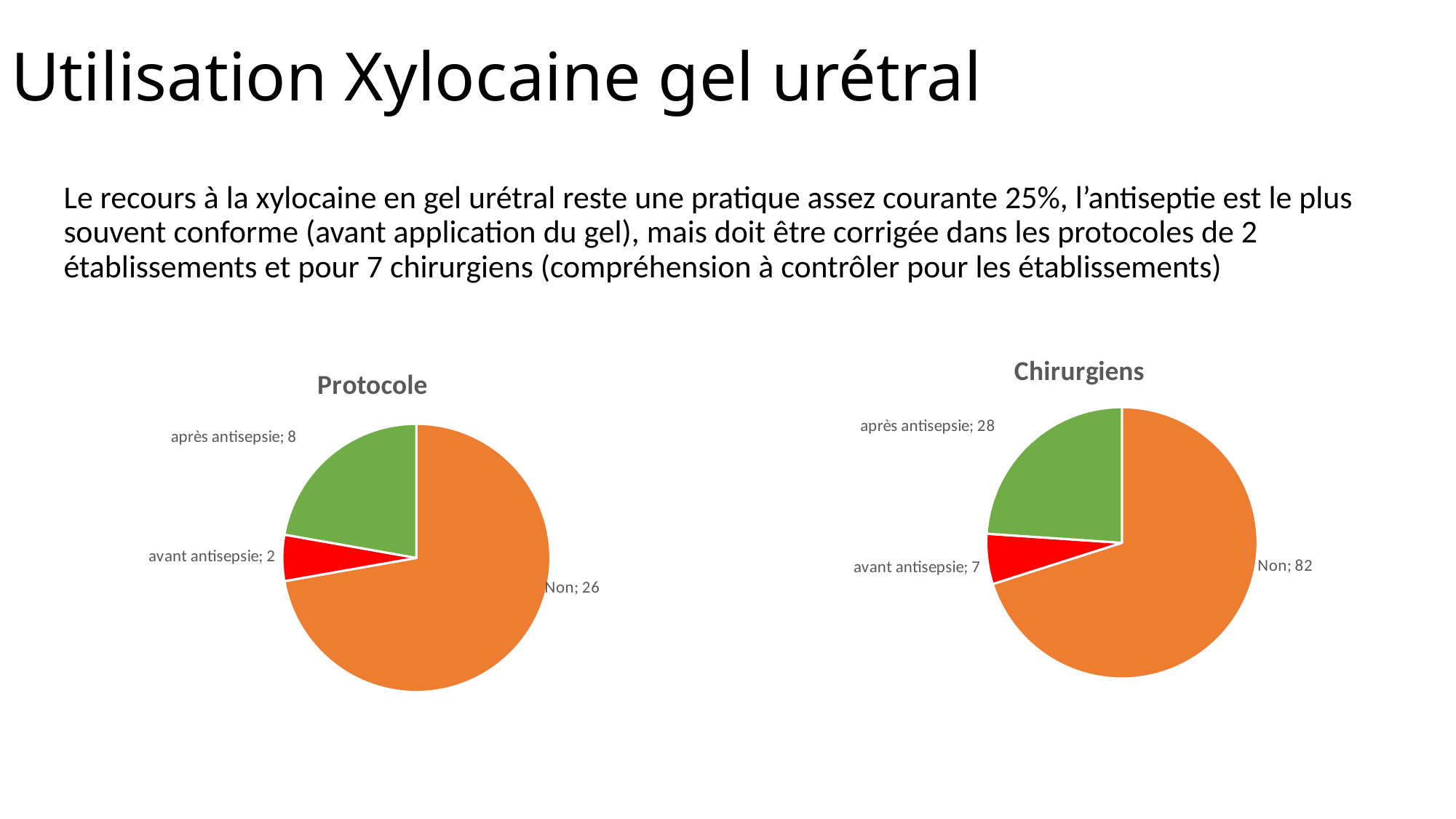
How many slices does the Chirurgiens pie chart have? 3 In the Protocole chart, what is the value for après antisepsie? 8 In the Chirurgiens chart, what is the value for après antisepsie? 28 In the Chirurgiens chart, which category has the largest slice? Non In the Protocole chart, what is the difference between après antisepsie and avant antisepsie? 6 In the Protocole chart, what is the value for Non? 26 In the Chirurgiens chart, what is the value for avant antisepsie? 7 In the Protocole chart, what colour is the avant antisepsie slice? red In the Protocole chart, which category has the smallest slice? avant antisepsie In the Protocole chart, which is larger: après antisepsie or avant antisepsie? après antisepsie In the Chirurgiens chart, what is the difference between Non and après antisepsie? 54 What type of chart is the Protocole chart? pie chart